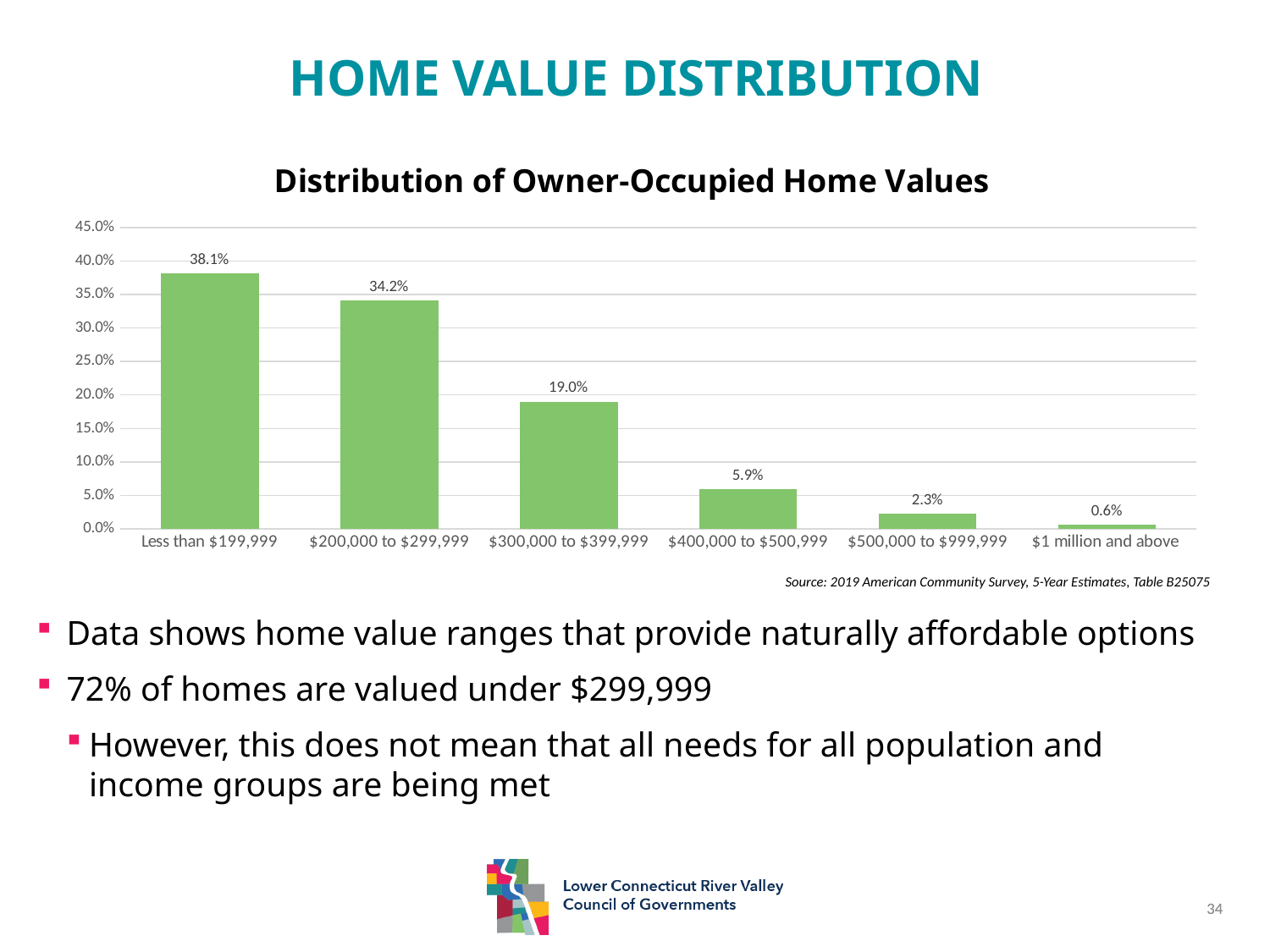
Which is larger, the value for "$200,000 to $299,999" or the value for "$300,000 to $399,999"? $200,000 to $299,999 What is the difference between the values for "Less than $199,999" and "$200,000 to $299,999"? 3.9% What kind of chart is shown on the slide? bar chart How many categories are shown on the x axis? 6 What is the value for the "$1 million and above" category? 0.6% What is the value for the "$500,000 to $999,999" category? 2.3% Which category has the highest value? Less than $199,999 What is the difference between the values for "$300,000 to $399,999" and "$400,000 to $500,999"? 13.1% Is the value for "$400,000 to $500,999" greater or less than 10.0%? less What is the value for the "$300,000 to $399,999" category? 19.0% Do the values rise or fall moving from left to right along the x axis? fall Which category has the lowest value? $1 million and above